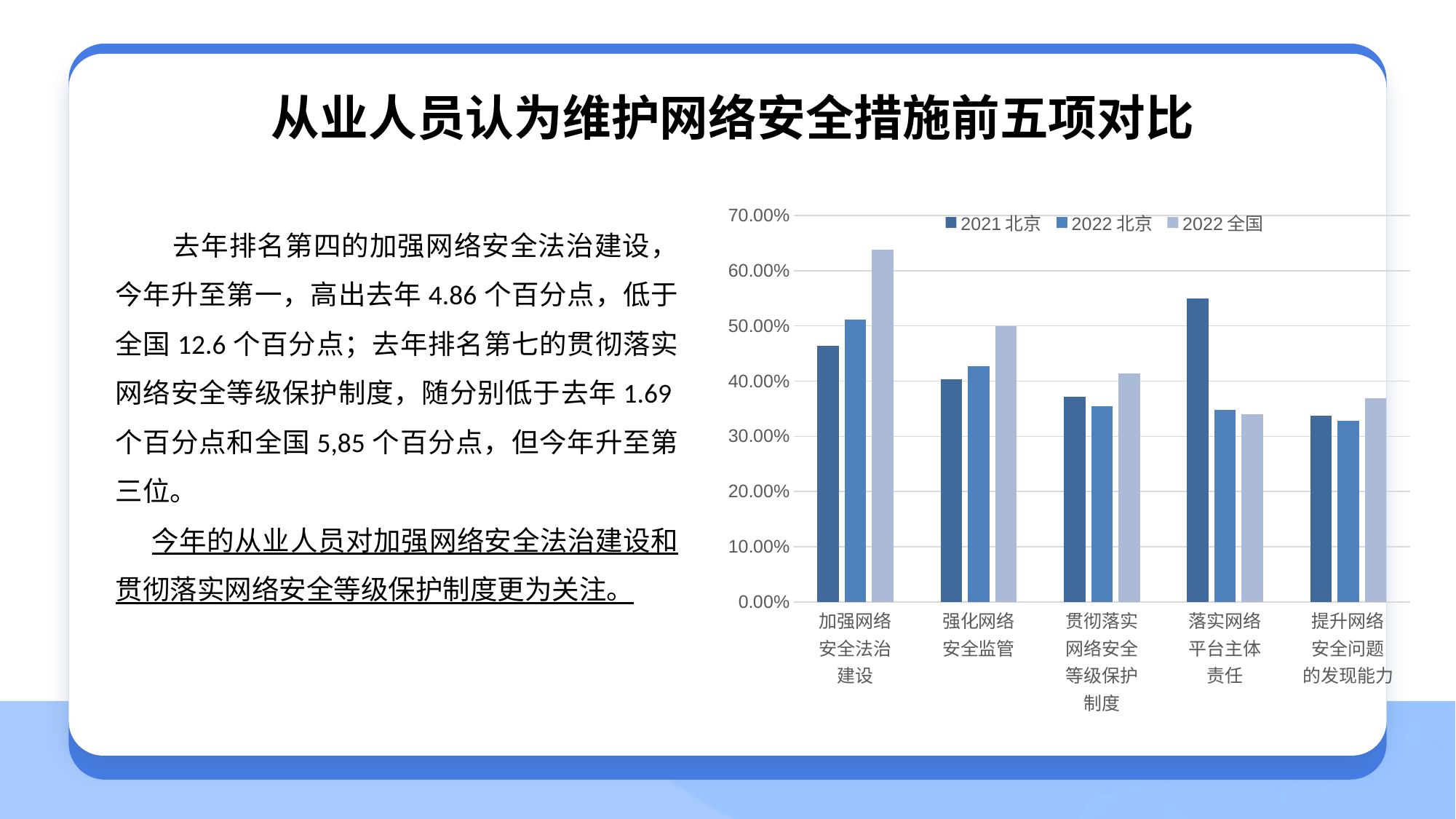
What kind of chart is shown on the slide? bar chart Is the 2021 北京 value for 落实网络平台主体责任 greater or less than 50.00%? greater Which category has the lowest 2022 全国 value? 落实网络平台主体责任 How many categories are shown on the x axis of the chart? 5 What is the title of the slide containing the chart? 从业人员认为维护网络安全措施前五项对比 Which category has the highest 2021 北京 value? 落实网络平台主体责任 What are the three series listed in the chart legend? 2021 北京, 2022 北京, 2022 全国 Is the 2022 全国 value for 加强网络安全法治建设 greater or less than 60.00%? greater Is the 2022 北京 value for 提升网络安全问题的发现能力 greater or less than 40.00%? less Which category has the highest 2022 全国 value? 加强网络安全法治建设 For 落实网络平台主体责任, which is larger: the 2021 北京 value or the 2022 北京 value? 2021 北京 How many series does the chart legend list? 3